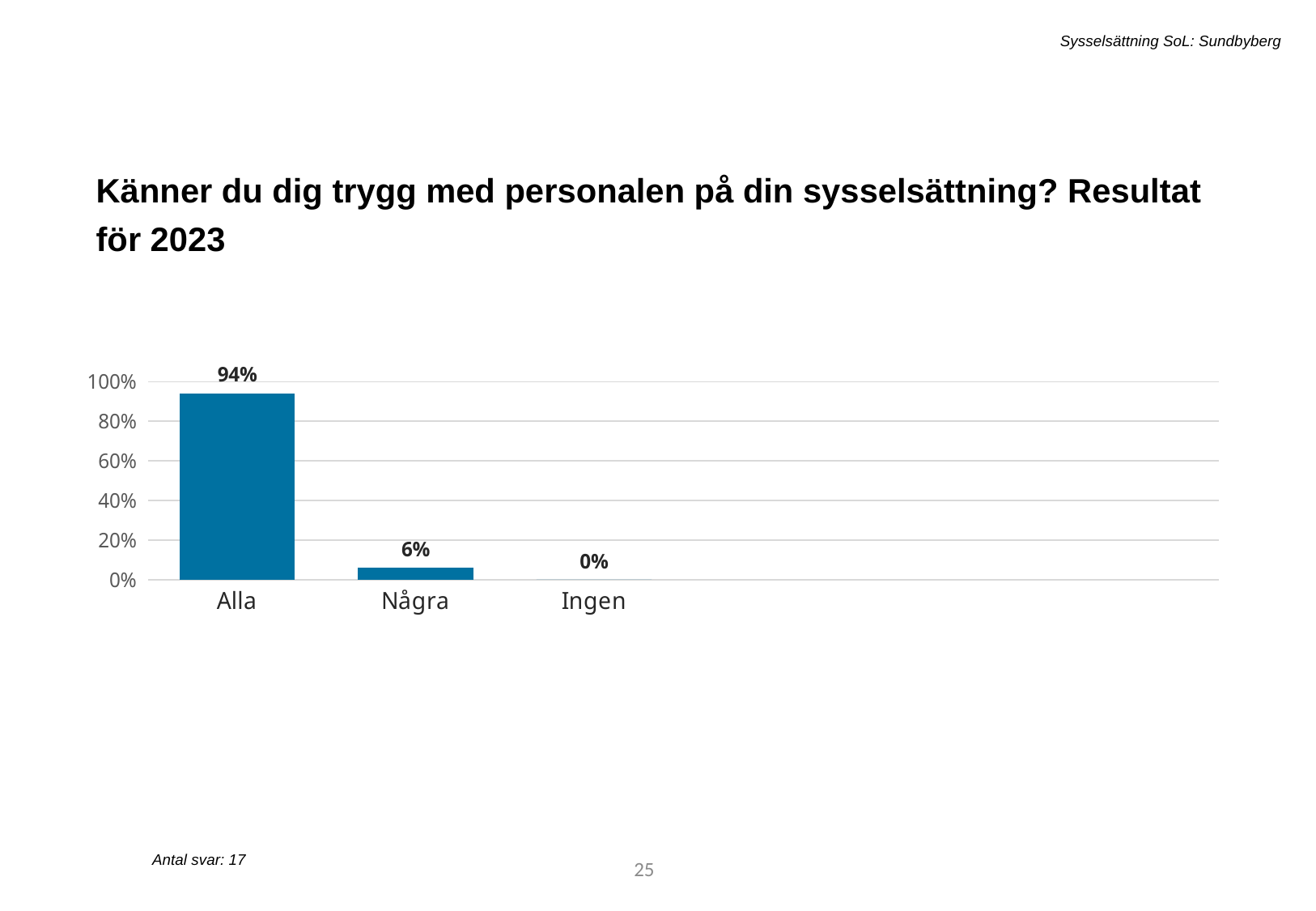
Which category has the highest value? Alla Is the value for Några greater or less than 20%? less What is the value for Ingen? 0% How many categories are shown on the x axis? 3 What kind of chart is shown on the slide? bar chart Which category has the lowest value? Ingen Which is larger, the value for Några or the value for Ingen? Några What is the value for Några? 6% Do the values rise or fall from left to right along the x axis? fall What is the difference between the values for Alla and Några? 88% What is the value for Alla? 94% Is the value for Alla greater or less than 80%? greater